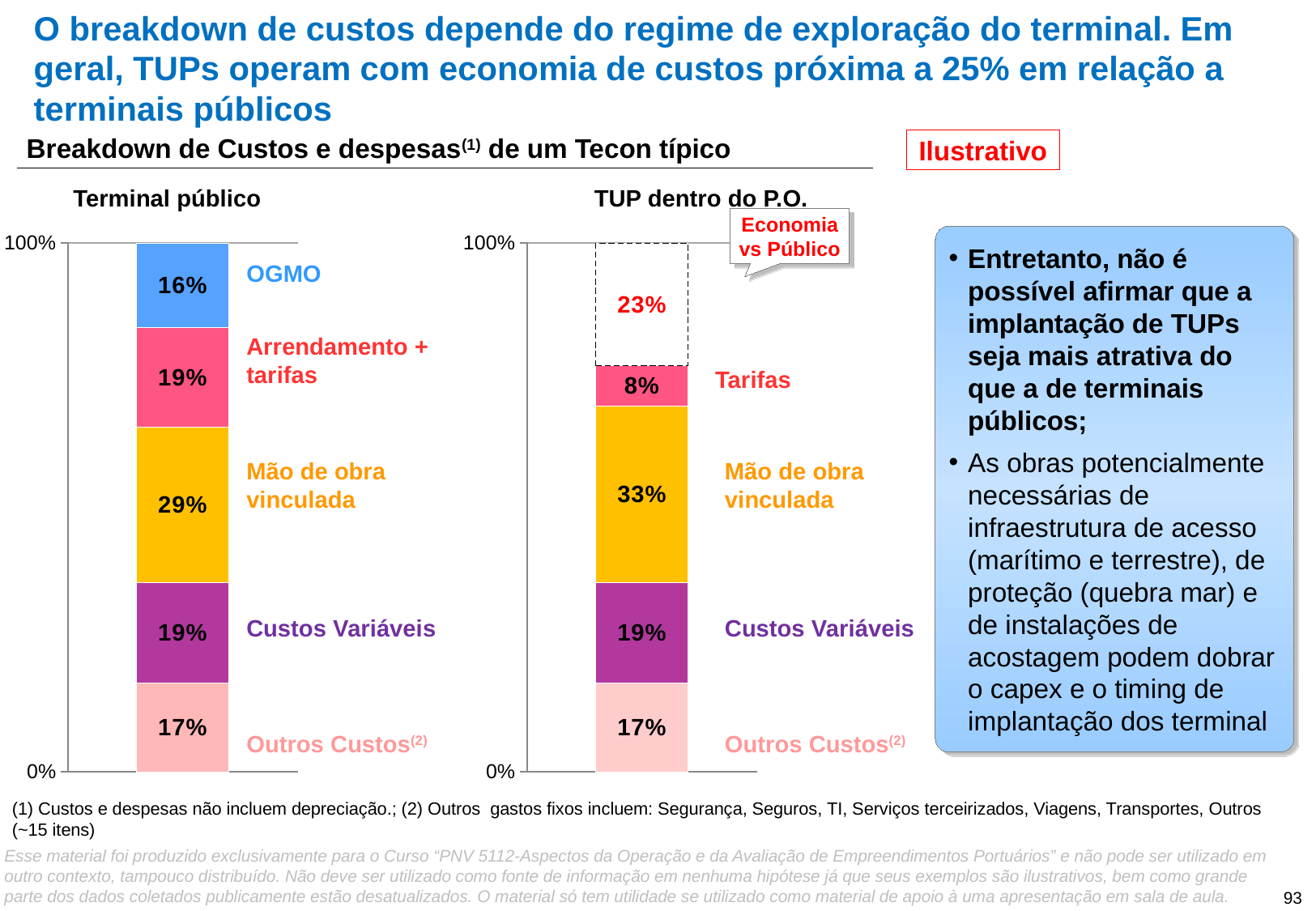
In the Terminal público chart, which segment has the largest value? Mão de obra vinculada In the TUP dentro do P.O. chart, which cost segment has the smallest value? Tarifas What is the difference between Mão de obra vinculada in the TUP dentro do P.O. chart and in the Terminal público chart? 4% In the TUP dentro do P.O. chart, what is the value for Tarifas? 8% In the Terminal público chart, what is the value for OGMO? 16% In the Terminal público chart, what is the total of the stacked bar? 100% Which is larger in the Terminal público chart: OGMO or Outros Custos? Outros Custos In the Terminal público chart, what is the value for Mão de obra vinculada? 29% In the Terminal público chart, how many segments make up the stacked bar? 5 In the TUP dentro do P.O. chart, what is the value shown for Economia vs Público? 23% What kind of chart is used for Terminal público? Stacked bar chart In the TUP dentro do P.O. chart, what is the value for Mão de obra vinculada? 33%